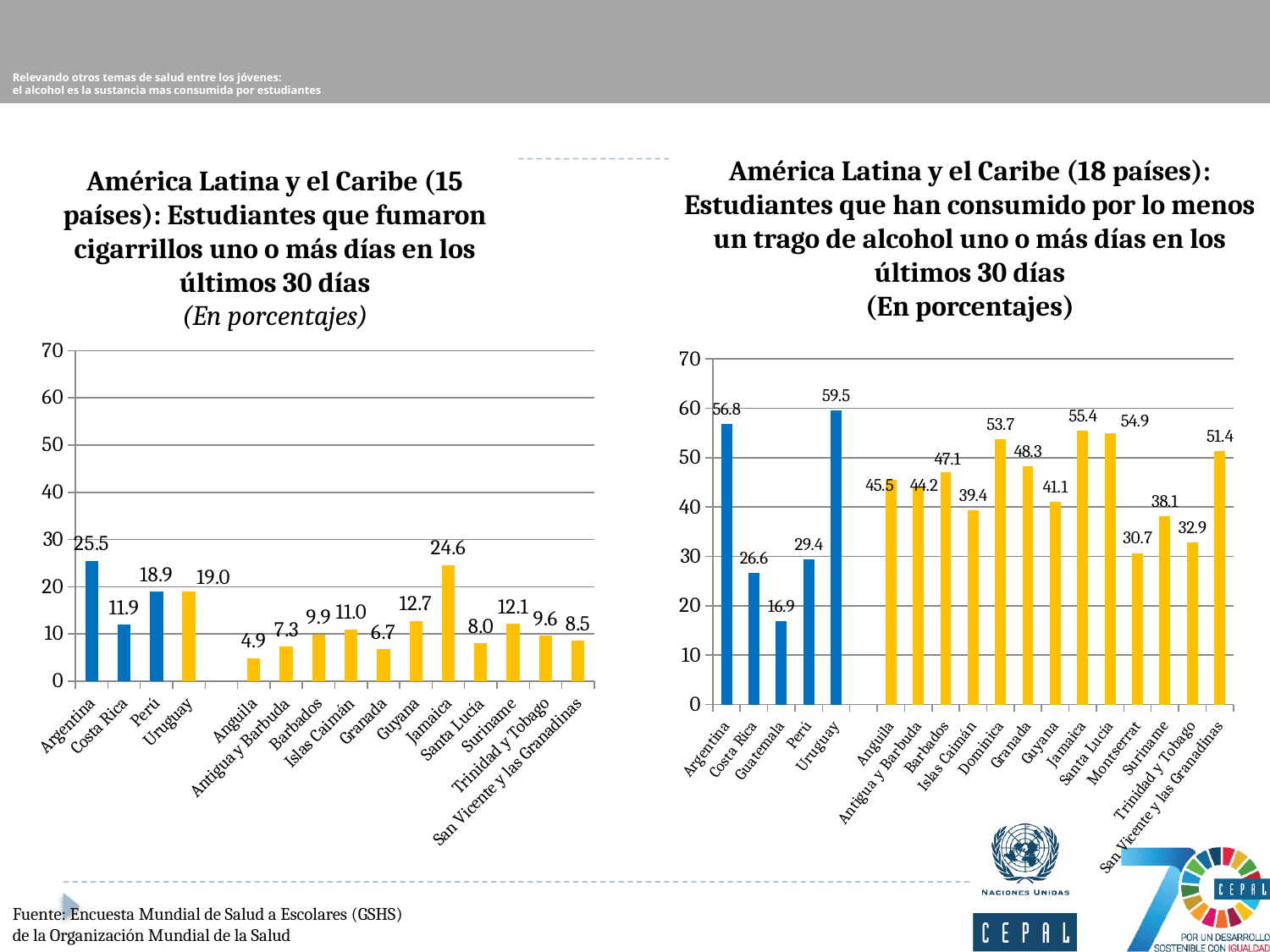
In the left chart (students who smoked cigarettes), what is the value for Argentina? 25.5 In the right chart (students who consumed alcohol), what is the difference between Jamaica and Santa Lucía? 0.5 In the right chart (students who consumed alcohol), what is the value for Uruguay? 59.5 In the right chart (students who consumed alcohol), which country has the highest value? Uruguay What type of chart is the right chart (students who consumed alcohol)? Bar chart In the left chart (students who smoked cigarettes), what is the difference between Argentina and Jamaica? 0.9 In the left chart (students who smoked cigarettes), which is larger, Costa Rica or Guyana? Guyana In the left chart (students who smoked cigarettes), which country has the lowest value? Anguila In the left chart (students who smoked cigarettes), how many countries are shown? 15 In the right chart (students who consumed alcohol), which country has the lowest value? Guatemala In the right chart (students who consumed alcohol), what is the value for Montserrat? 30.7 In the right chart (students who consumed alcohol), how many countries are shown? 18